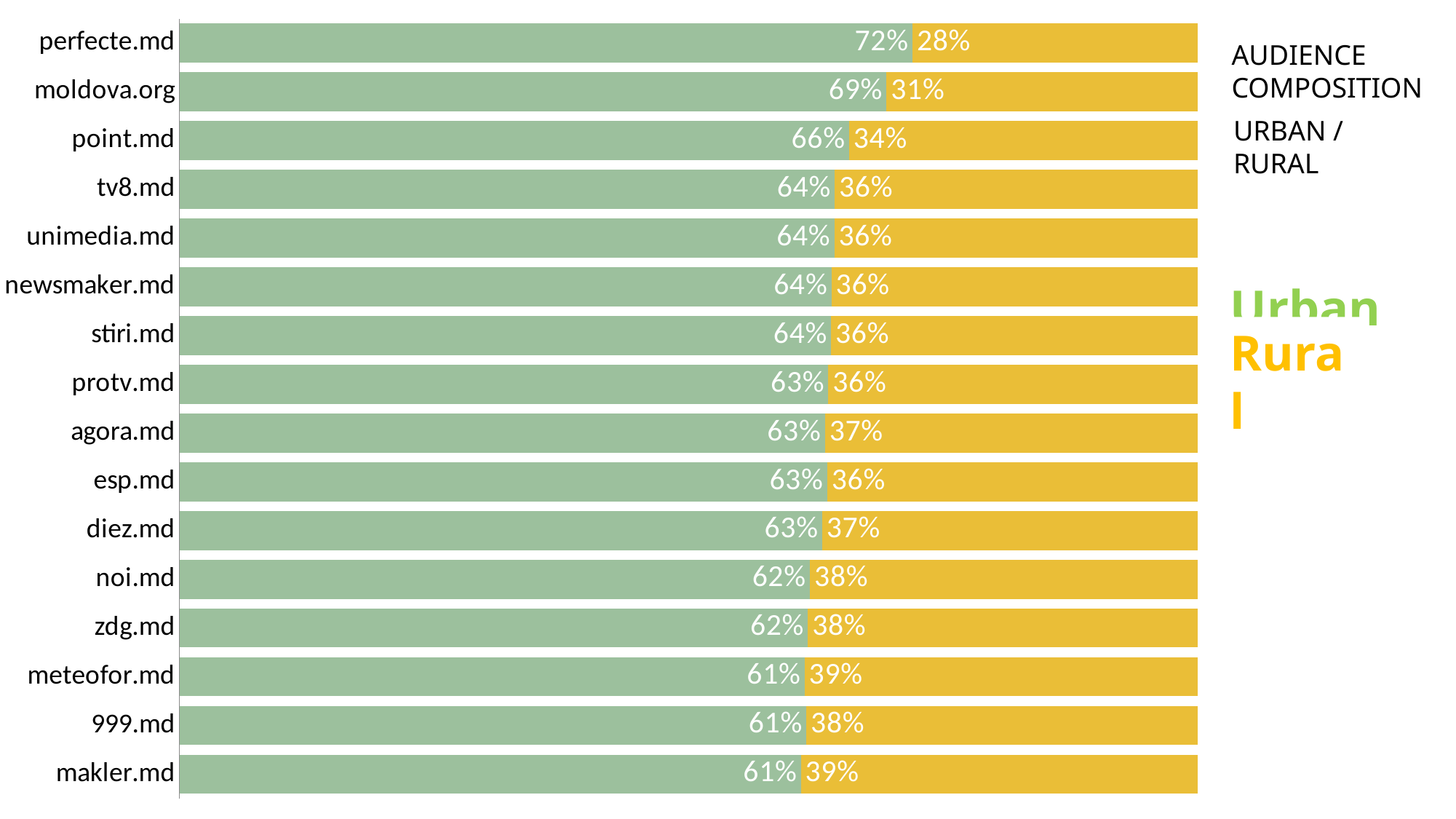
Which website has the lowest Rural share? perfecte.md What is the Urban share for perfecte.md? 72% What kind of chart is shown on the slide? Stacked bar chart What is the Rural share for point.md? 34% What is the Rural share for noi.md? 38% What is the Urban share for makler.md? 61% Which has a larger Urban share, moldova.org or point.md? moldova.org Which colour represents the Rural series? Yellow How many websites are shown in the chart? 16 Which website has the highest Urban share? perfecte.md What is the difference between the Urban and Rural shares for perfecte.md? 44 percentage points How many series does the chart show? 2